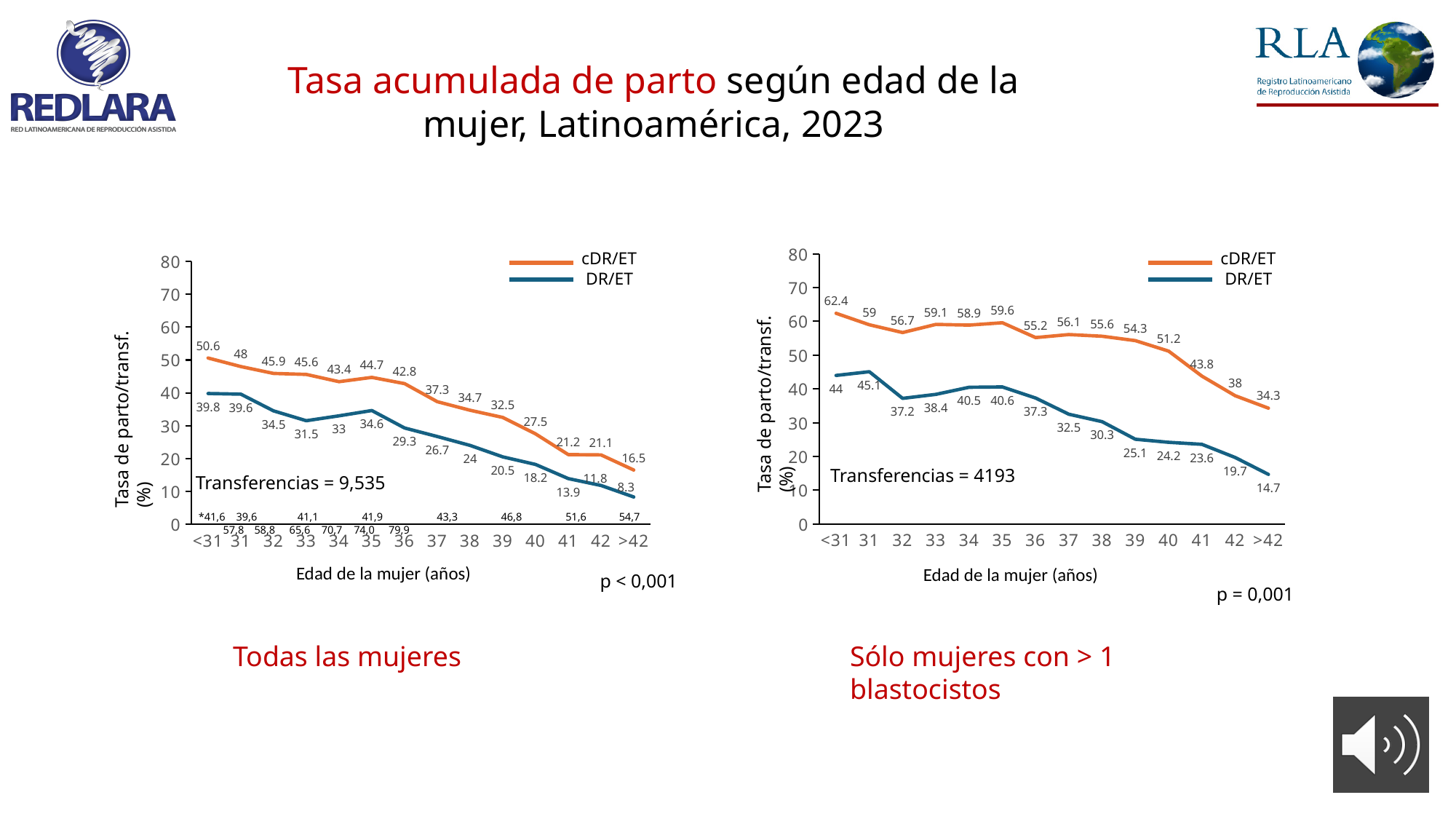
In the left chart (Todas las mujeres), what is the cDR/ET value for women aged <31? 50.6 In the right chart (Sólo mujeres con > 1 blastocistos), which age group has the highest cDR/ET value? <31 How many series does the legend of the right chart (Sólo mujeres con > 1 blastocistos) list? 2 In the left chart (Todas las mujeres), which age group has the lowest DR/ET value? >42 In the right chart (Sólo mujeres con > 1 blastocistos), what is the cDR/ET value for women aged 36? 55.2 What type of chart is the left chart (Todas las mujeres)? Line chart In the right chart (Sólo mujeres con > 1 blastocistos), which is larger: the DR/ET value at age 31 or at age 32? Age 31 In the left chart (Todas las mujeres), what is the difference between the cDR/ET and DR/ET values for women aged 38? 10.7 In the left chart (Todas las mujeres), what is the DR/ET value for women aged 40? 18.2 In the right chart (Sólo mujeres con > 1 blastocistos), what is the DR/ET value for women aged >42? 14.7 In the left chart (Todas las mujeres), does the cDR/ET series generally rise or fall as age increases? Fall How many age categories are shown on the x axis of the left chart (Todas las mujeres)? 14